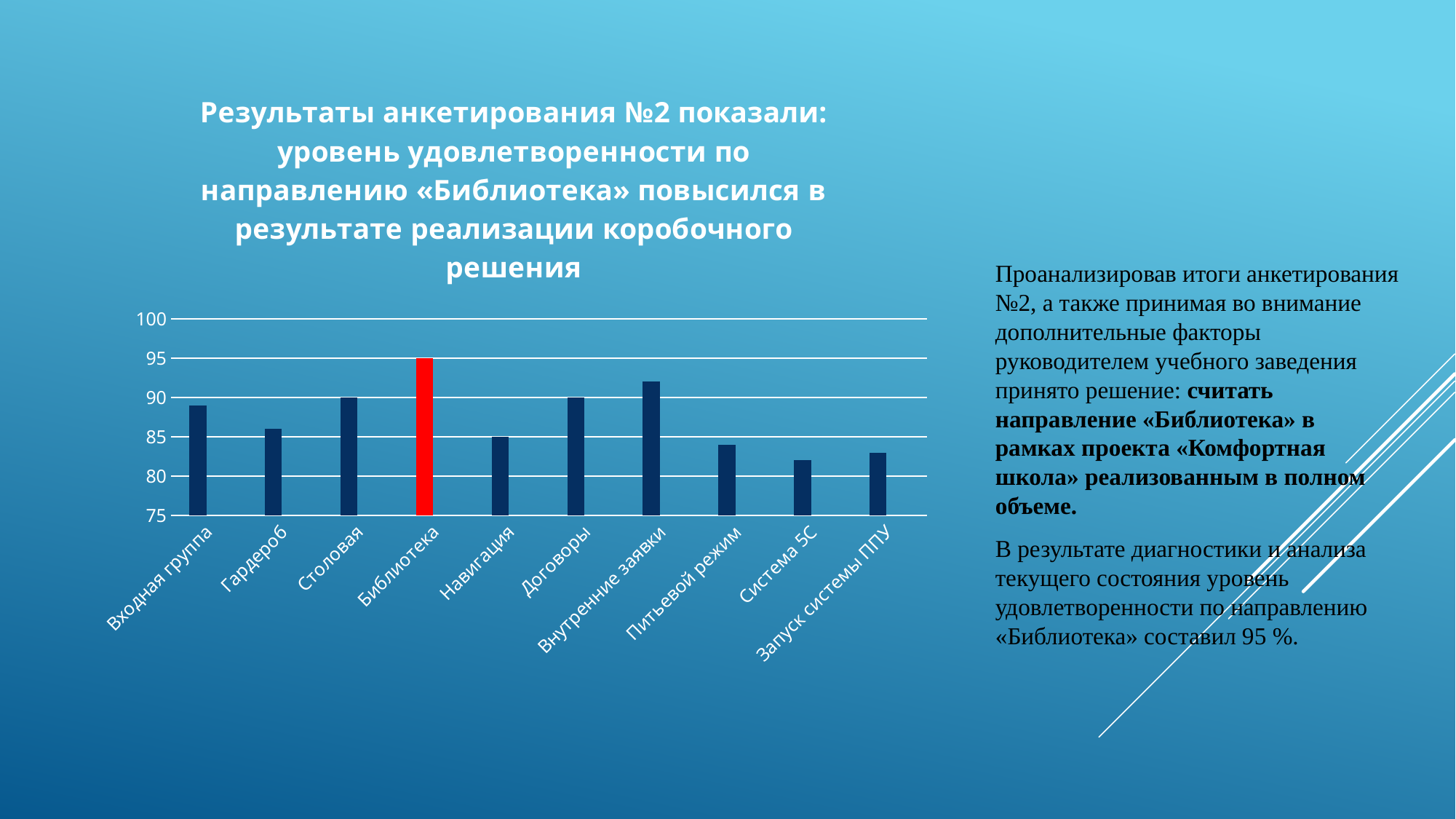
What is the value for Библиотека? 95 What is the value for Навигация? 85 How many categories are shown on the x axis of the chart? 10 What is the value for Столовая? 90 What is the difference between the values for Библиотека and Столовая? 5 Is the value for Питьевой режим greater or less than 85? less Which category has the highest value in the chart? Библиотека Is the value for Входная группа greater or less than 85? greater Is the value for Внутренние заявки greater or less than 90? greater Which is larger, the value for Внутренние заявки or the value for Навигация? Внутренние заявки What kind of chart is shown on the slide? bar chart Which category's bar is coloured red in the chart? Библиотека